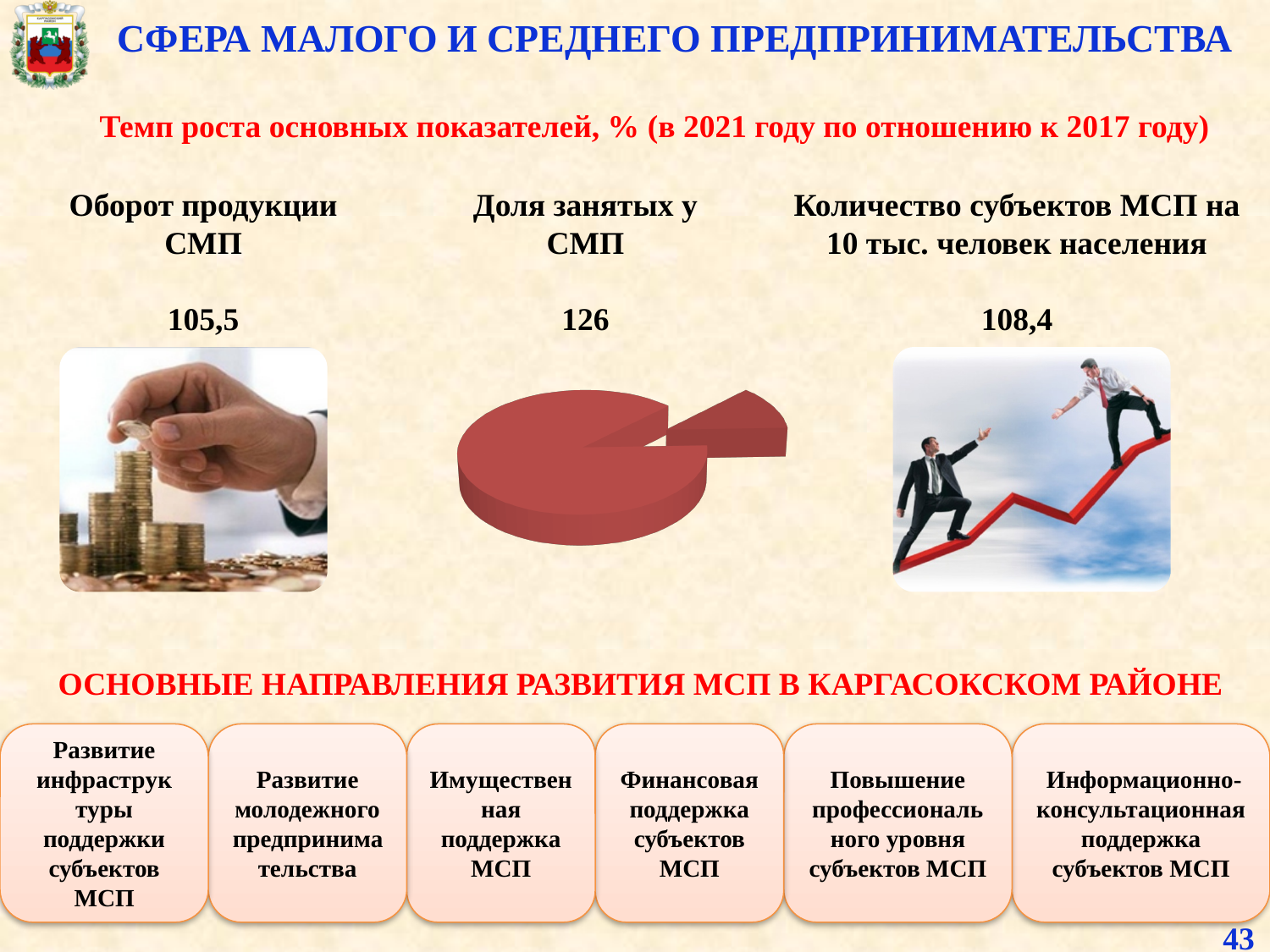
Does the pie chart have a legend? No How many slices does the pie chart have? 2 In the pie chart, is the separated (exploded) slice larger or smaller than the remaining slice? smaller What colour are the slices of the pie chart? red What kind of chart is shown in the middle of the slide under "Доля занятых у СМП"? pie chart